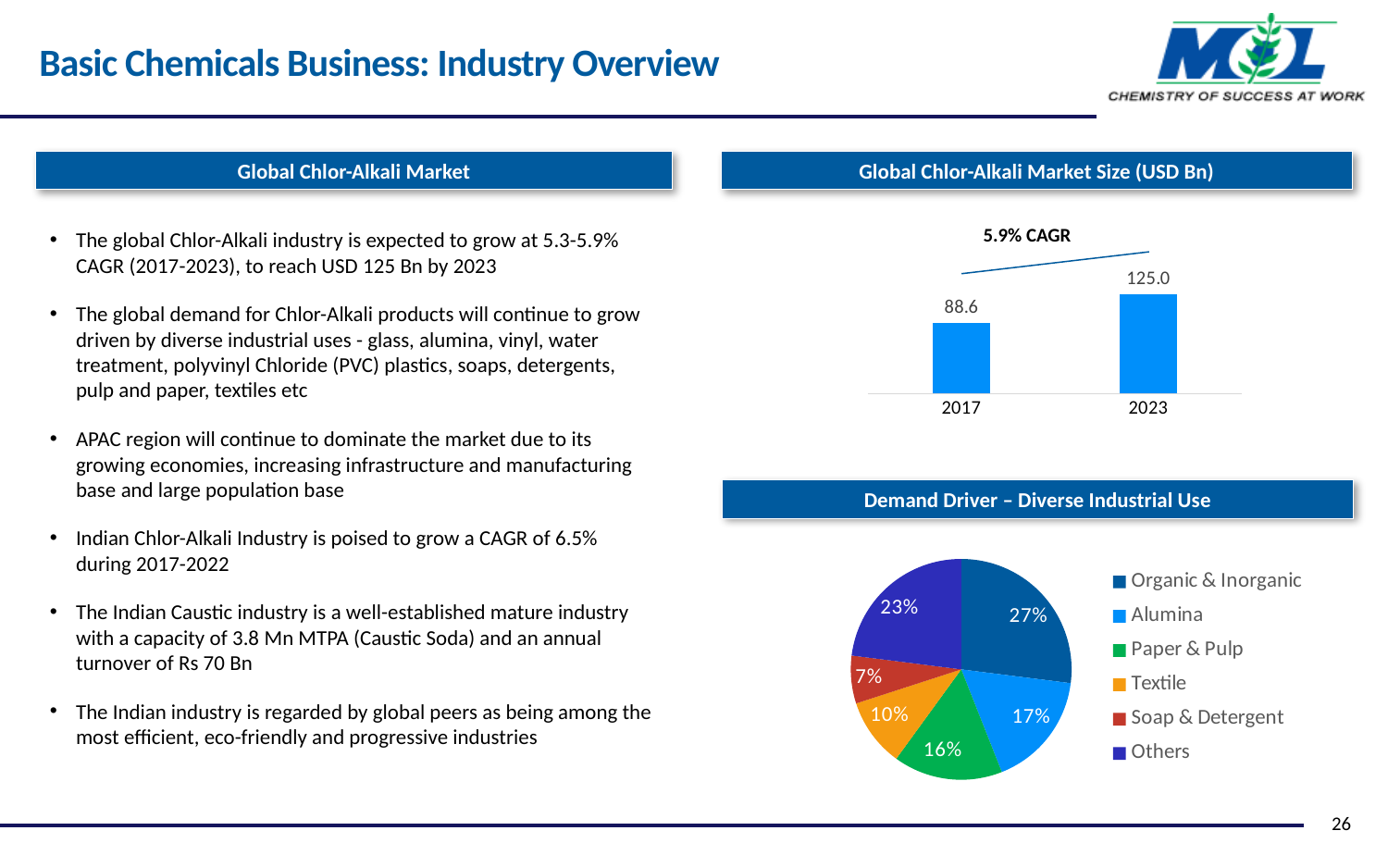
In the Demand Driver – Diverse Industrial Use pie chart, which category has the largest share? Organic & Inorganic In the Global Chlor-Alkali Market Size (USD Bn) chart, what is the value for 2017? 88.6 In the Global Chlor-Alkali Market Size (USD Bn) chart, which year has the higher value? 2023 In the Demand Driver – Diverse Industrial Use pie chart, what share does Soap & Detergent have? 7% In the Global Chlor-Alkali Market Size (USD Bn) chart, what is the difference between the 2023 and 2017 values? 36.4 In the Demand Driver – Diverse Industrial Use pie chart, what share does Organic & Inorganic have? 27% How many categories does the legend of the Demand Driver – Diverse Industrial Use pie chart list? 6 What kind of chart is the Global Chlor-Alkali Market Size (USD Bn) chart? Bar chart In the Global Chlor-Alkali Market Size (USD Bn) chart, what CAGR is shown above the bars? 5.9% CAGR In the Demand Driver – Diverse Industrial Use pie chart, which category has the smallest share? Soap & Detergent In the Demand Driver – Diverse Industrial Use pie chart, what share does Alumina have? 17% In the Global Chlor-Alkali Market Size (USD Bn) chart, what is the value for 2023? 125.0